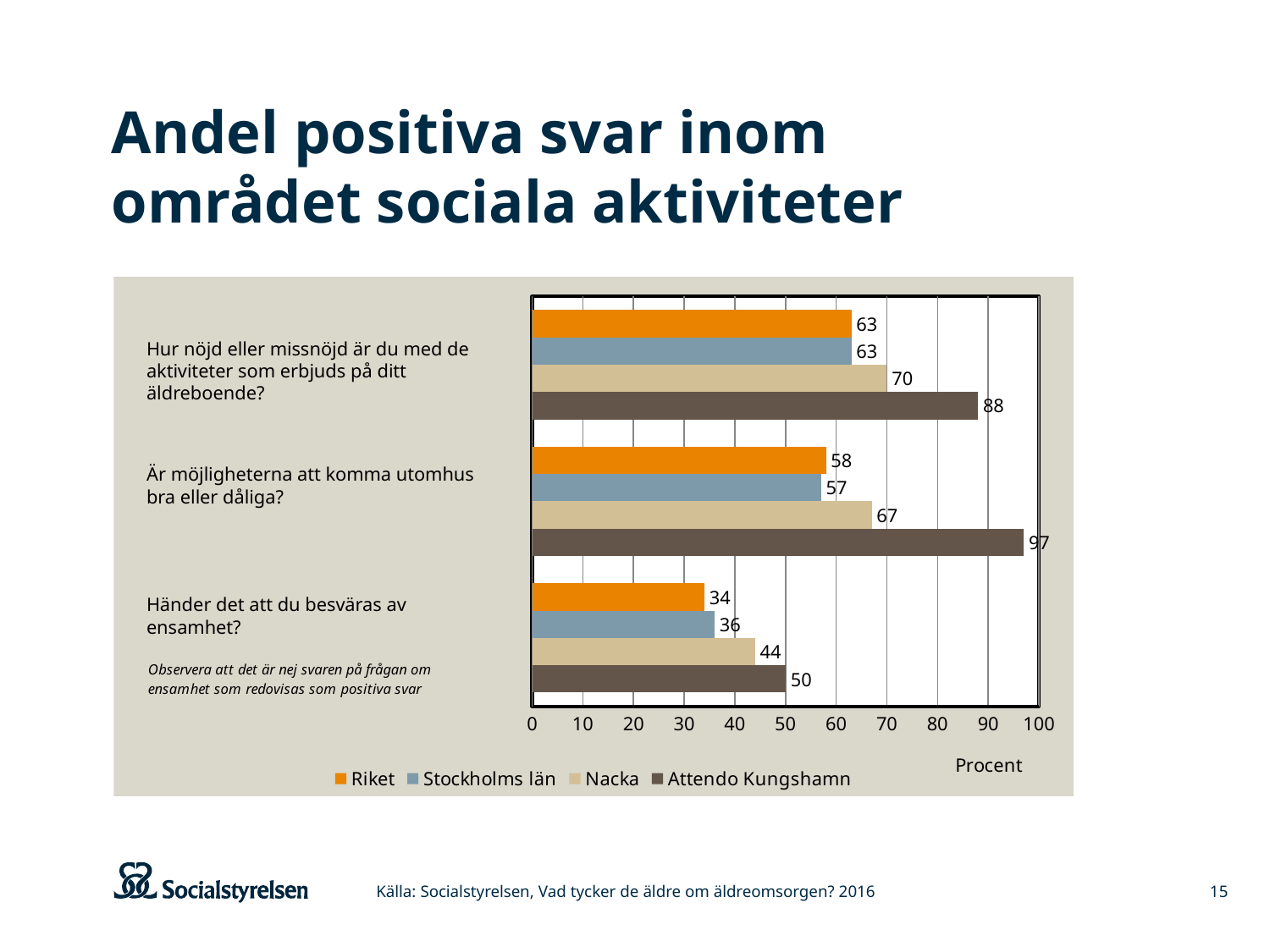
How many question categories are shown on the chart? 3 What unit is shown on the horizontal axis of the chart? Procent Which series has the highest value on the question "Hur nöjd eller missnöjd är du med de aktiviteter som erbjuds på ditt äldreboende?"? Attendo Kungshamn Which series has the lowest value on the question "Händer det att du besväras av ensamhet?"? Riket What is the difference between Nacka and Stockholms län on the question "Händer det att du besväras av ensamhet?"? 8 What is the value for Attendo Kungshamn on the question "Är möjligheterna att komma utomhus bra eller dåliga?"? 97 Which is larger: Nacka on "Är möjligheterna att komma utomhus bra eller dåliga?" or Nacka on "Händer det att du besväras av ensamhet?"? Är möjligheterna att komma utomhus bra eller dåliga? How many series does the legend list? 4 What kind of chart is shown on the slide? Bar chart What is the value for Nacka on the question "Hur nöjd eller missnöjd är du med de aktiviteter som erbjuds på ditt äldreboende?"? 70 What is the value for Riket on the question "Händer det att du besväras av ensamhet?"? 34 What is the difference between Attendo Kungshamn and Riket on the question "Är möjligheterna att komma utomhus bra eller dåliga?"? 39